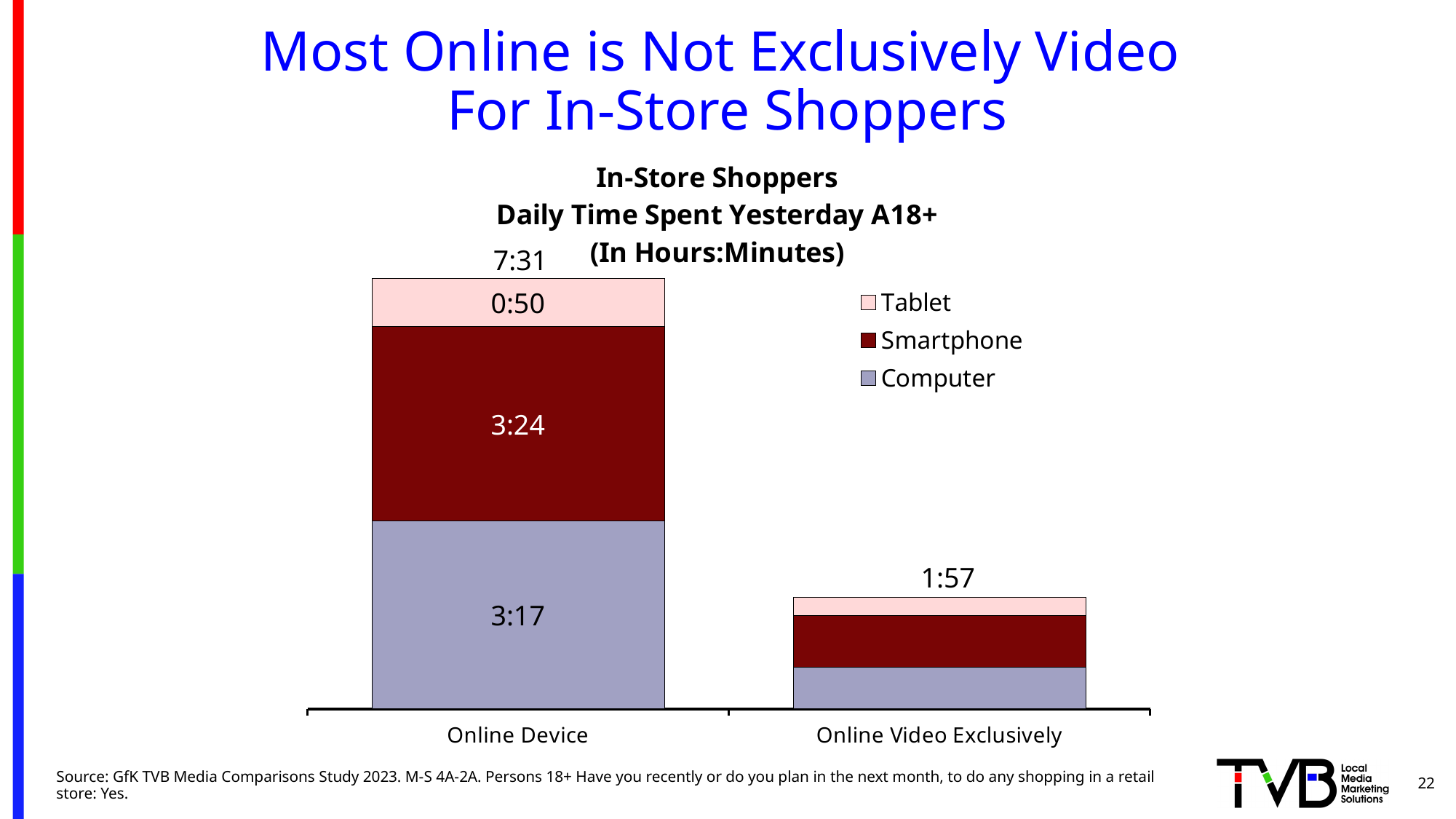
Within the Online Device bar, which device segment is the smallest? Tablet Within the Online Device bar, which is larger, Smartphone or Computer? Smartphone Which category has the higher total time spent, Online Device or Online Video Exclusively? Online Device What is the Tablet value for Online Device? 0:50 What kind of chart is shown on the slide? Stacked bar chart What is the difference between the Online Device total and the Online Video Exclusively total? 5:34 What is the Computer value for Online Device? 3:17 What is the total daily time spent for Online Video Exclusively? 1:57 What is the Smartphone value for Online Device? 3:24 What is the total daily time spent for Online Device? 7:31 How many categories are shown on the x axis? 2 How many series does the legend list? 3